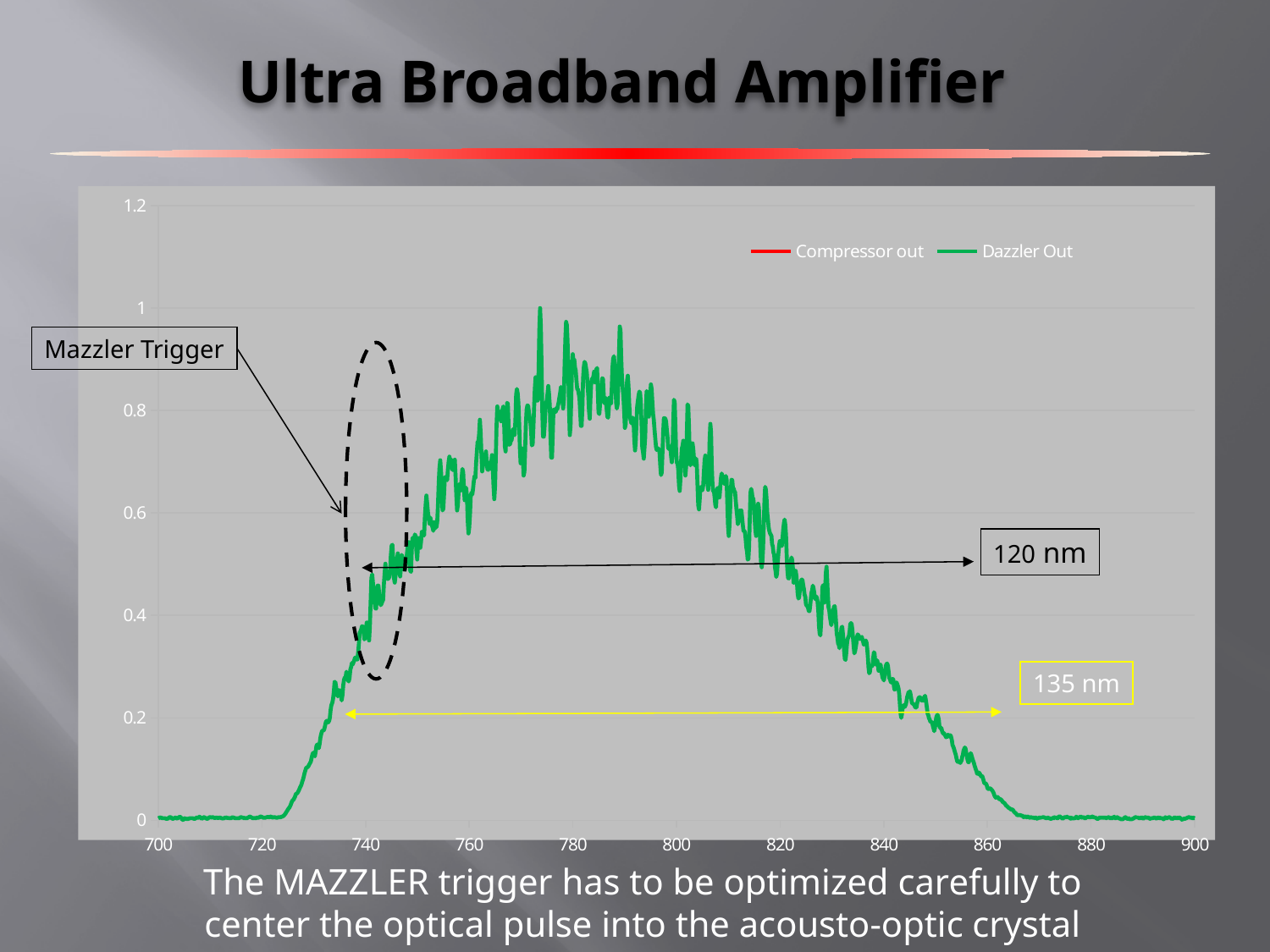
Does the Dazzler Out curve rise or fall between 700 and 780 on the x axis? rise How many series does the legend list? 2 Does the Dazzler Out curve rise or fall between 800 and 900 on the x axis? fall What kind of chart is shown on the slide? line chart Which series is drawn in green according to the legend? Dazzler Out Is the Dazzler Out value at 860 greater or less than 0.2? less What bandwidth value is shown in the yellow annotation box? 135 nm Is the Dazzler Out value at 740 greater or less than 0.6? less Is the Dazzler Out value at 720 greater or less than 0.2? less How many labelled tick marks are on the x axis? 11